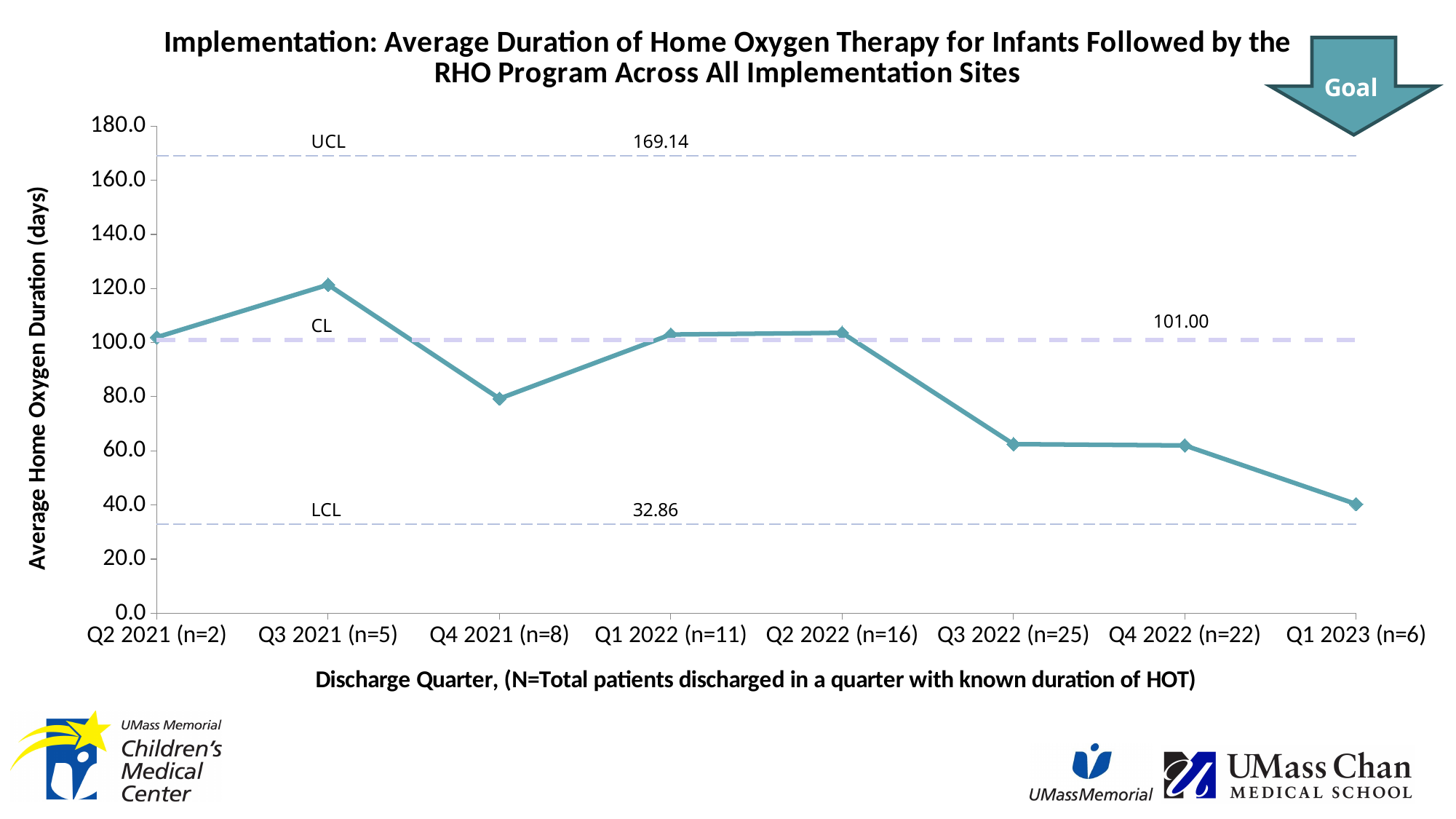
What kind of chart is shown on the slide? line chart Is the average home oxygen duration for Q3 2021 (n=5) greater or less than 100.0 days? greater Is the average home oxygen duration for Q3 2022 (n=25) greater or less than 40.0 days? greater What is the value of the LCL (lower control limit) shown on the chart? 32.86 Which has a higher average home oxygen duration, Q3 2021 (n=5) or Q4 2021 (n=8)? Q3 2021 (n=5) What is the value of the UCL (upper control limit) shown on the chart? 169.14 Which discharge quarter has the lowest average home oxygen duration? Q1 2023 (n=6) Which discharge quarter has the highest average home oxygen duration? Q3 2021 (n=5) How many discharge quarters are plotted on the chart? 8 What is the value of the CL (center line) shown on the chart? 101.00 Is the average home oxygen duration for Q1 2023 (n=6) greater or less than 60.0 days? less Does the average home oxygen duration rise or fall from Q2 2022 (n=16) to Q1 2023 (n=6)? fall